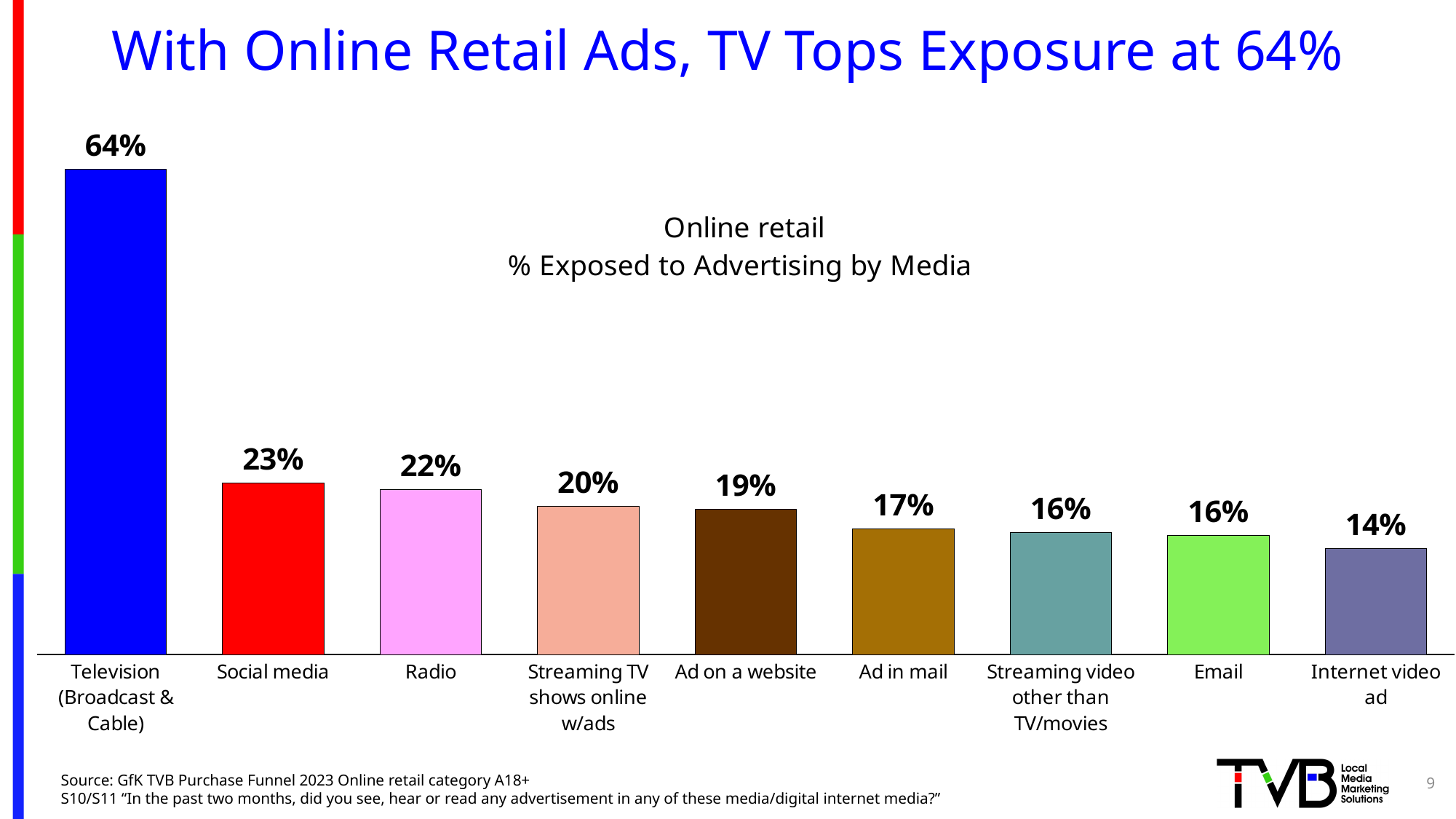
What is the value shown for Radio? 22% Do the values rise or fall moving from left to right across the categories? Fall What type of chart is shown on the slide? Bar chart Which media category has the lowest exposure percentage? Internet video ad What is the title of the chart? Online retail % Exposed to Advertising by Media Which is larger, the value for Social media or the value for Ad on a website? Social media What is the difference between the Television (Broadcast & Cable) value and the Social media value? 41% Which media category has the highest exposure percentage? Television (Broadcast & Cable) How many media categories are shown in the chart? 9 What is the value shown for Ad in mail? 17% What is the difference between the Streaming TV shows online w/ads value and the Internet video ad value? 6% What percentage of respondents were exposed to online retail advertising on Television (Broadcast & Cable)? 64%